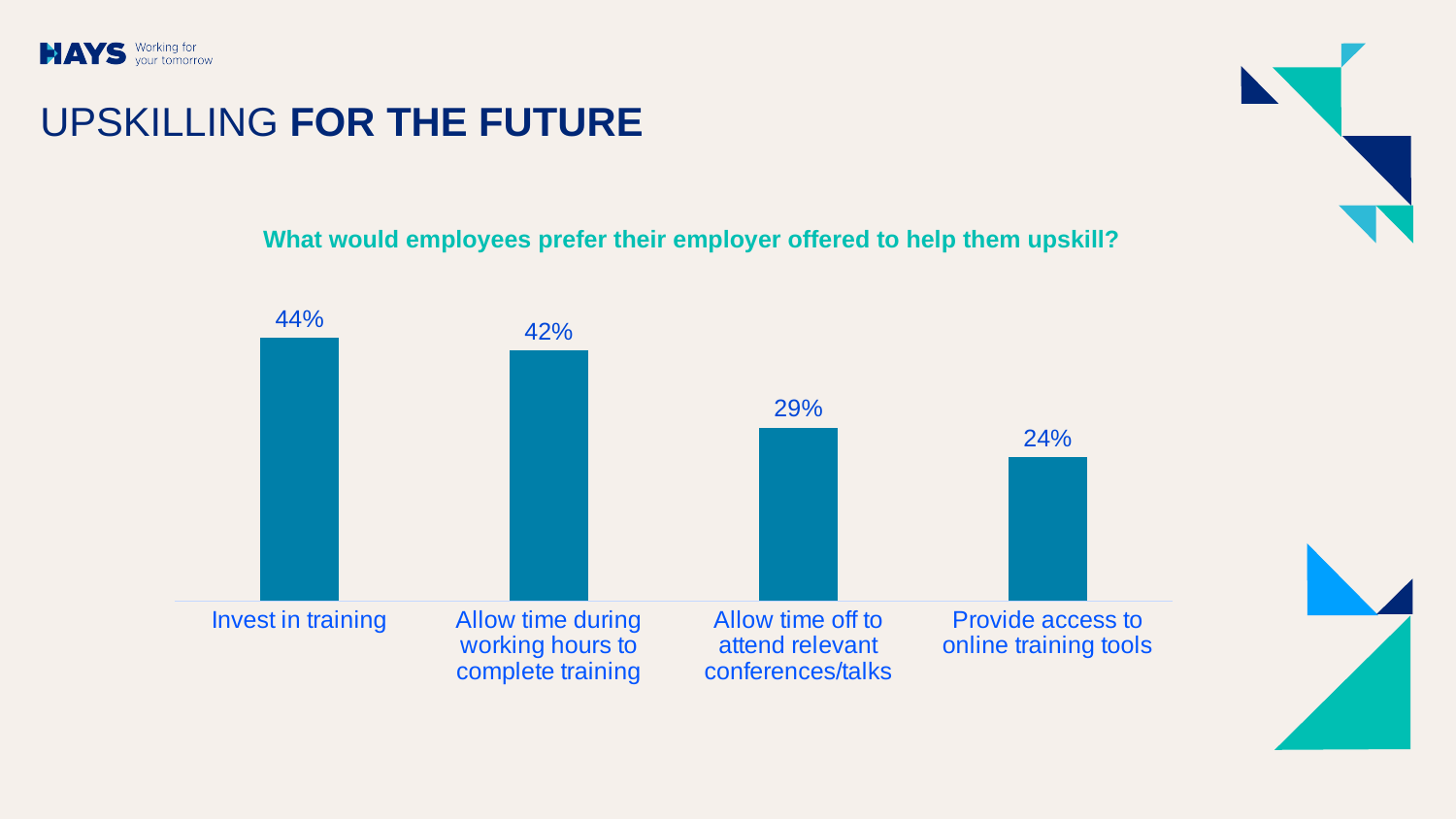
What is the difference between 'Allow time during working hours to complete training' and 'Allow time off to attend relevant conferences/talks'? 13% Do the values rise or fall from left to right across the chart? Fall Which is larger: 'Allow time off to attend relevant conferences/talks' or 'Provide access to online training tools'? Allow time off to attend relevant conferences/talks What is the value for 'Provide access to online training tools'? 24% What is the value for 'Allow time during working hours to complete training'? 42% What kind of chart is shown on the slide? Bar chart Which option has the highest percentage? Invest in training What percentage of employees would prefer their employer to invest in training? 44% What is the difference between 'Invest in training' and 'Provide access to online training tools'? 20% Which option has the lowest percentage? Provide access to online training tools What is the value for 'Allow time off to attend relevant conferences/talks'? 29% How many options are shown in the chart? 4